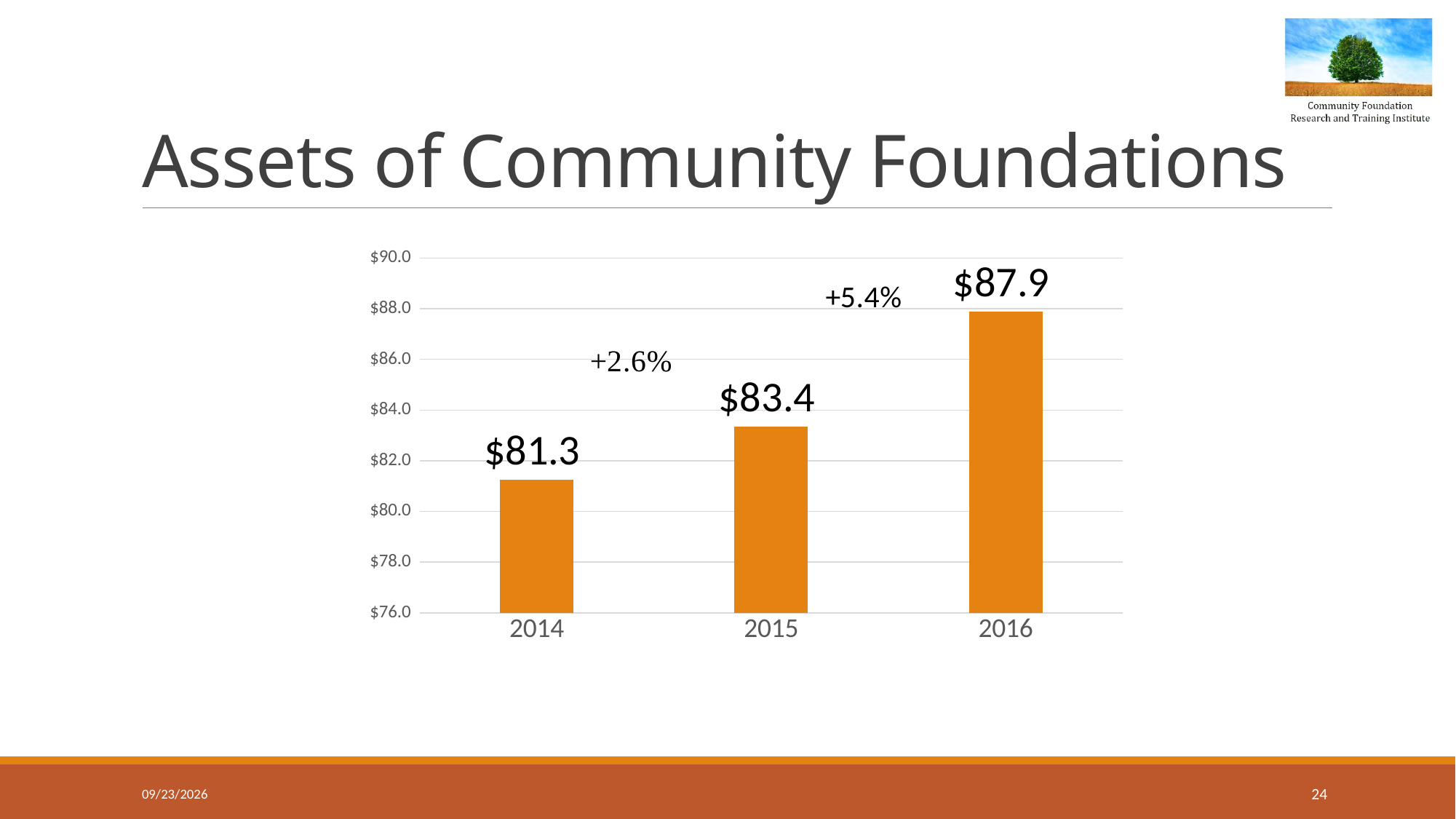
How many years are shown on the chart? 3 Do the values rise or fall from 2014 to 2016? rise Is the value for 2015 greater or less than $84.0? less What is the value for 2015? $83.4 Which is larger, the value for 2015 or the value for 2016? 2016 Which year has the lowest value? 2014 What is the value for 2014? $81.3 What is the difference between the values for 2016 and 2014? $6.6 What kind of chart is shown on the slide? bar chart What is the value for 2016? $87.9 What is the difference between the values for 2015 and 2014? $2.1 Which year has the highest value? 2016